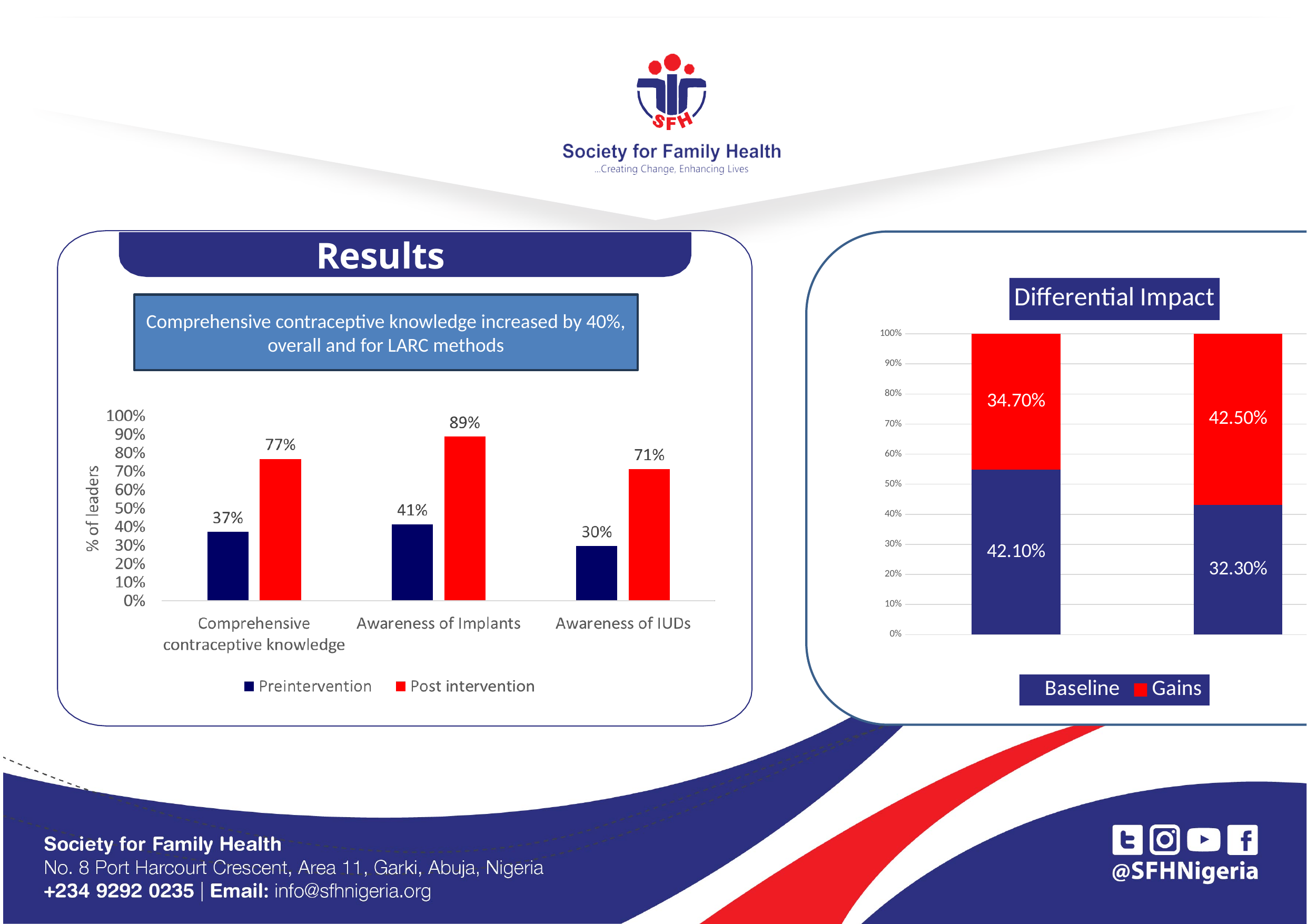
On the left chart under Results, what is the difference between the Post intervention and Preintervention values for Comprehensive contraceptive knowledge? 40% On the left chart under Results, which category has the highest Post intervention value? Awareness of Implants On the left chart under Results, which category has the lowest Preintervention value? Awareness of IUDs On the Differential Impact chart, what is the Baseline value for the right bar? 32.30% On the left chart under Results, what kind of chart is it? Bar chart On the left chart under Results, what is the Preintervention value for Comprehensive contraceptive knowledge? 37% On the left chart under Results, what is the Preintervention value for Awareness of IUDs? 30% On the Differential Impact chart, which series is shown in red according to the legend? Gains On the left chart under Results, how many categories are shown on the x axis? 3 On the left chart under Results, what is the Post intervention value for Awareness of Implants? 89% On the Differential Impact chart, what is the Gains value for the left bar? 34.70% On the left chart under Results, how many series does the legend list? 2